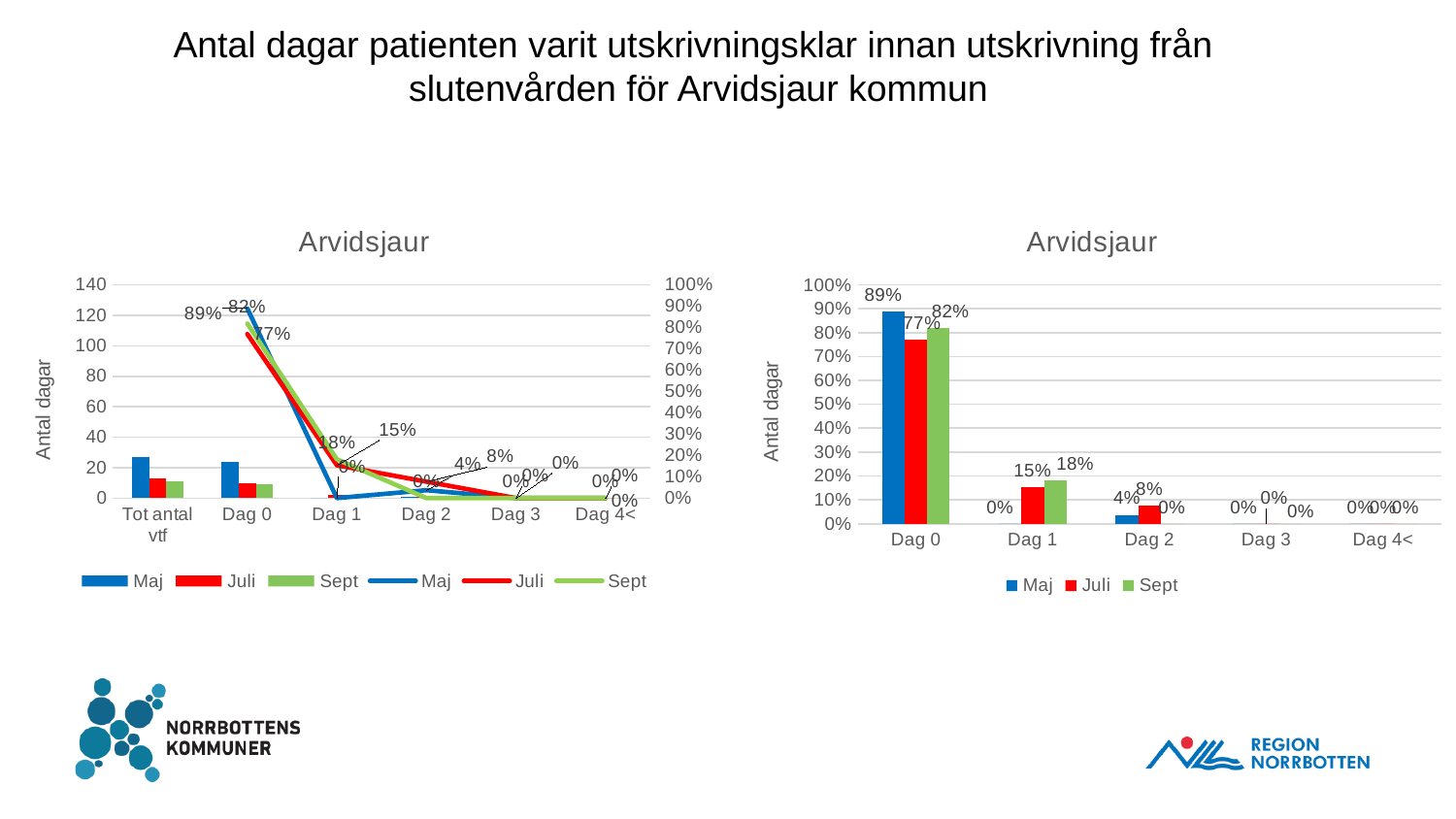
In the left-hand chart, is the Maj bar for Tot antal vtf greater or less than 20? greater In the right-hand chart, what is the value for Maj at Dag 0? 89% In the right-hand chart, which is larger at Dag 1: Juli or Sept? Sept In the right-hand chart, what is the value for Sept at Dag 1? 18% In the left-hand chart, is the Juli bar for Tot antal vtf greater or less than 20? less In the right-hand chart, which series has the highest value at Dag 0? Maj In the right-hand chart, what is the value for Juli at Dag 2? 8% In the right-hand chart, how many categories are shown on the x axis? 5 What is the label on the vertical axis of the right-hand chart? Antal dagar In the right-hand chart, what is the value for Juli at Dag 0? 77% In the right-hand chart, what is the difference between the Sept and Juli values at Dag 0? 5% In the right-hand chart, how many series does the legend list? 3